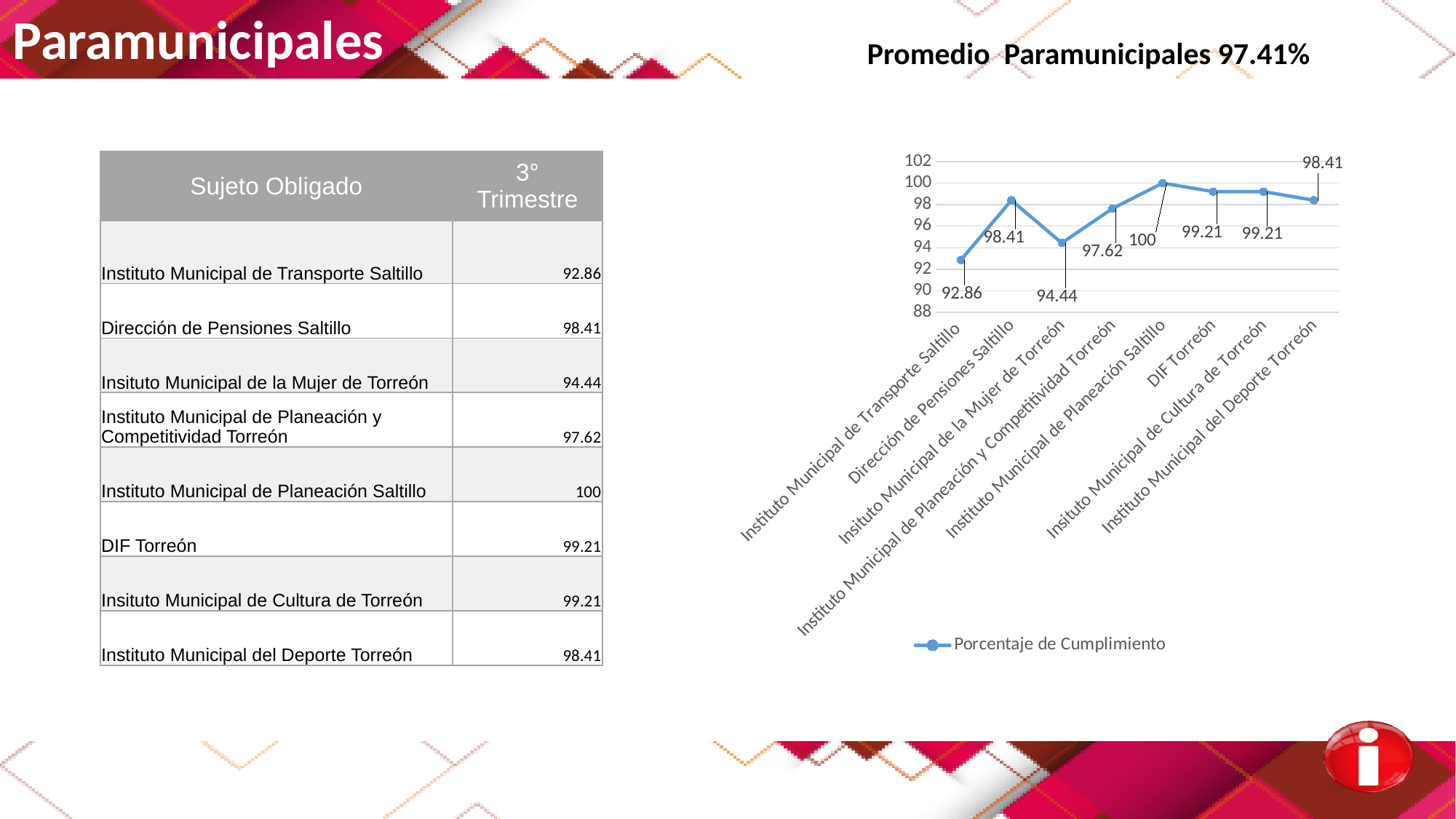
What is the difference between the value for Instituto Municipal de Planeación Saltillo and the value for Instituto Municipal de Transporte Saltillo? 7.14 Is the value for Insituto Municipal de la Mujer de Torreón greater or less than 96? less What is the value plotted for Instituto Municipal de Transporte Saltillo? 92.86 Which category has the highest value on the chart? Instituto Municipal de Planeación Saltillo What is the value plotted for Instituto Municipal del Deporte Torreón? 98.41 Which category has the lowest value on the chart? Instituto Municipal de Transporte Saltillo What is the value plotted for Instituto Municipal de Planeación y Competitividad Torreón? 97.62 What is the value plotted for DIF Torreón? 99.21 Which has the larger value, Dirección de Pensiones Saltillo or Insituto Municipal de la Mujer de Torreón? Dirección de Pensiones Saltillo How many series does the chart legend list? 1 How many categories are plotted on the chart? 8 What kind of chart is shown on the slide? line chart